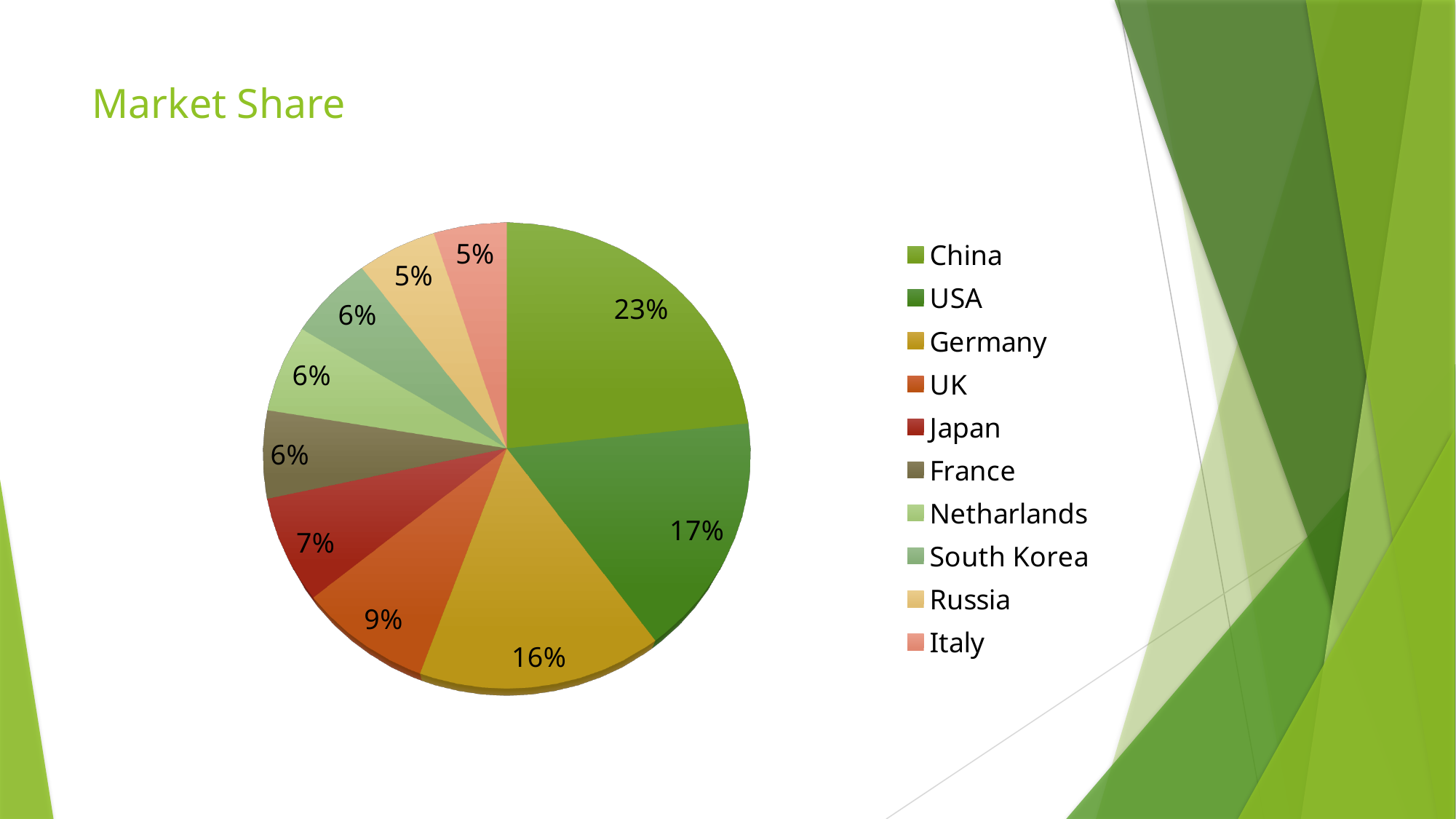
What is the value for Russia? 5% What is the title of the chart? Market Share What is the difference between the shares of China and USA? 6% What share of the pie does Germany hold? 16% Which country has the largest slice of the pie? China What type of chart is shown on the slide? Pie chart What is the difference between the shares of the UK and Japan? 2% How many categories does the legend list? 10 Which is larger, the share for USA or the share for Germany? USA What share of the pie does China hold? 23% What is the value for Japan? 7% What is the value for the UK? 9%